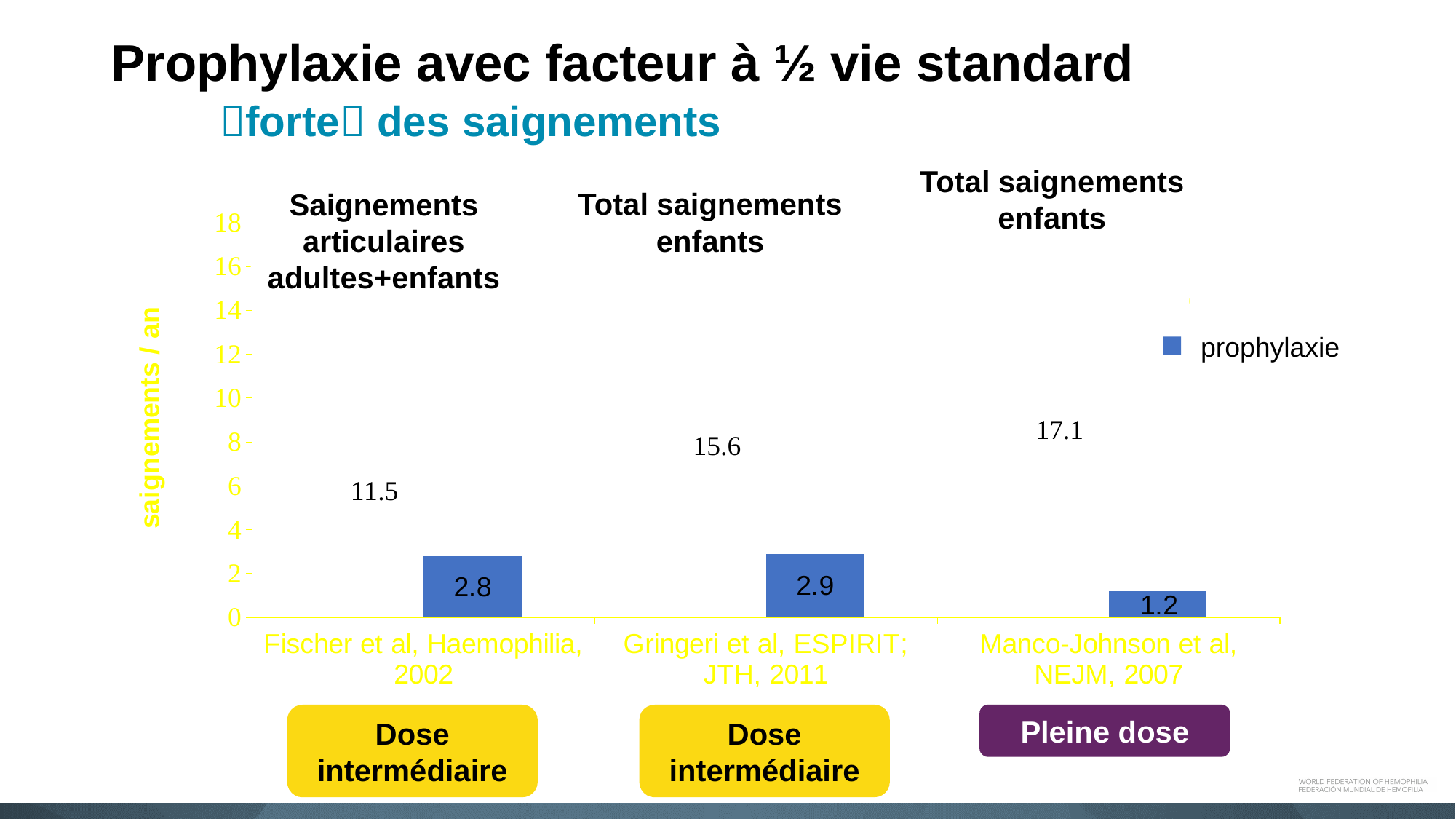
What kind of chart is shown on the slide? bar chart How many series does the legend list? 1 Which study has the highest prophylaxie bar? Gringeri et al, ESPIRIT; JTH, 2011 What is the prophylaxie value for Gringeri et al, ESPIRIT; JTH, 2011? 2.9 What is the difference between the prophylaxie values for Gringeri et al, ESPIRIT; JTH, 2011 and Manco-Johnson et al, NEJM, 2007? 1.7 Is the prophylaxie value for Manco-Johnson et al, NEJM, 2007 greater or less than 2? less What is the title of the vertical axis? saignements / an Which is larger: the prophylaxie value for Fischer et al, Haemophilia, 2002 or for Manco-Johnson et al, NEJM, 2007? Fischer et al, Haemophilia, 2002 How many studies (categories) are shown on the x axis? 3 What is the prophylaxie value for Manco-Johnson et al, NEJM, 2007? 1.2 Which study has the lowest prophylaxie bar? Manco-Johnson et al, NEJM, 2007 What is the prophylaxie value for Fischer et al, Haemophilia, 2002? 2.8